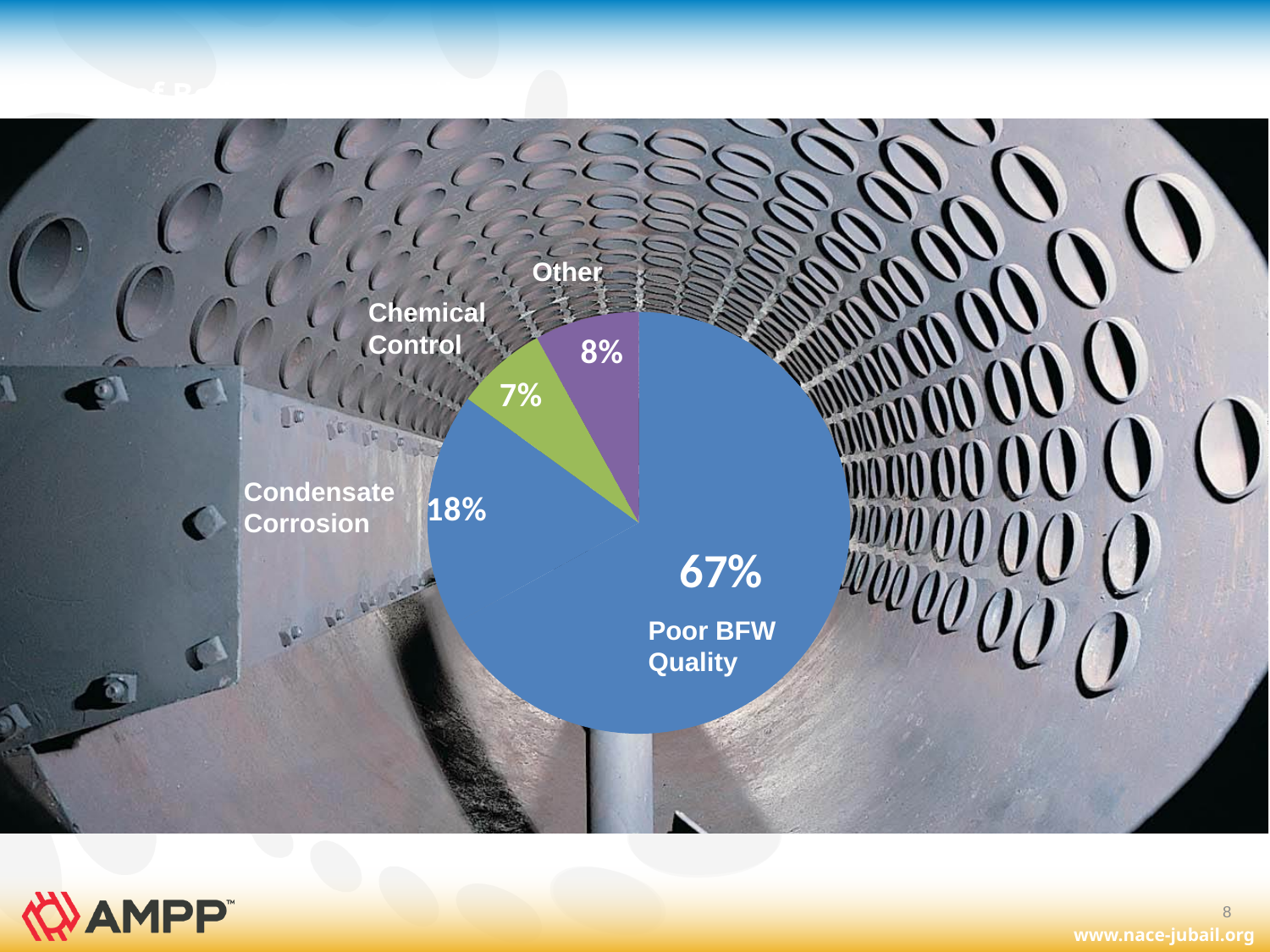
What is the combined share of Chemical Control and Other? 15% What percentage of the pie is Chemical Control? 7% How many slices does the pie chart have? 4 Which category has the largest share of the pie? Poor BFW Quality What percentage of the pie is Other? 8% What is the difference in percentage points between Poor BFW Quality and Condensate Corrosion? 49 Which is larger, the share for Other or the share for Chemical Control? Other What kind of chart is shown on the slide? pie chart Which category has the smallest share of the pie? Chemical Control What percentage of the pie is Poor BFW Quality? 67% What colour is the Chemical Control slice? green What percentage of the pie is Condensate Corrosion? 18%